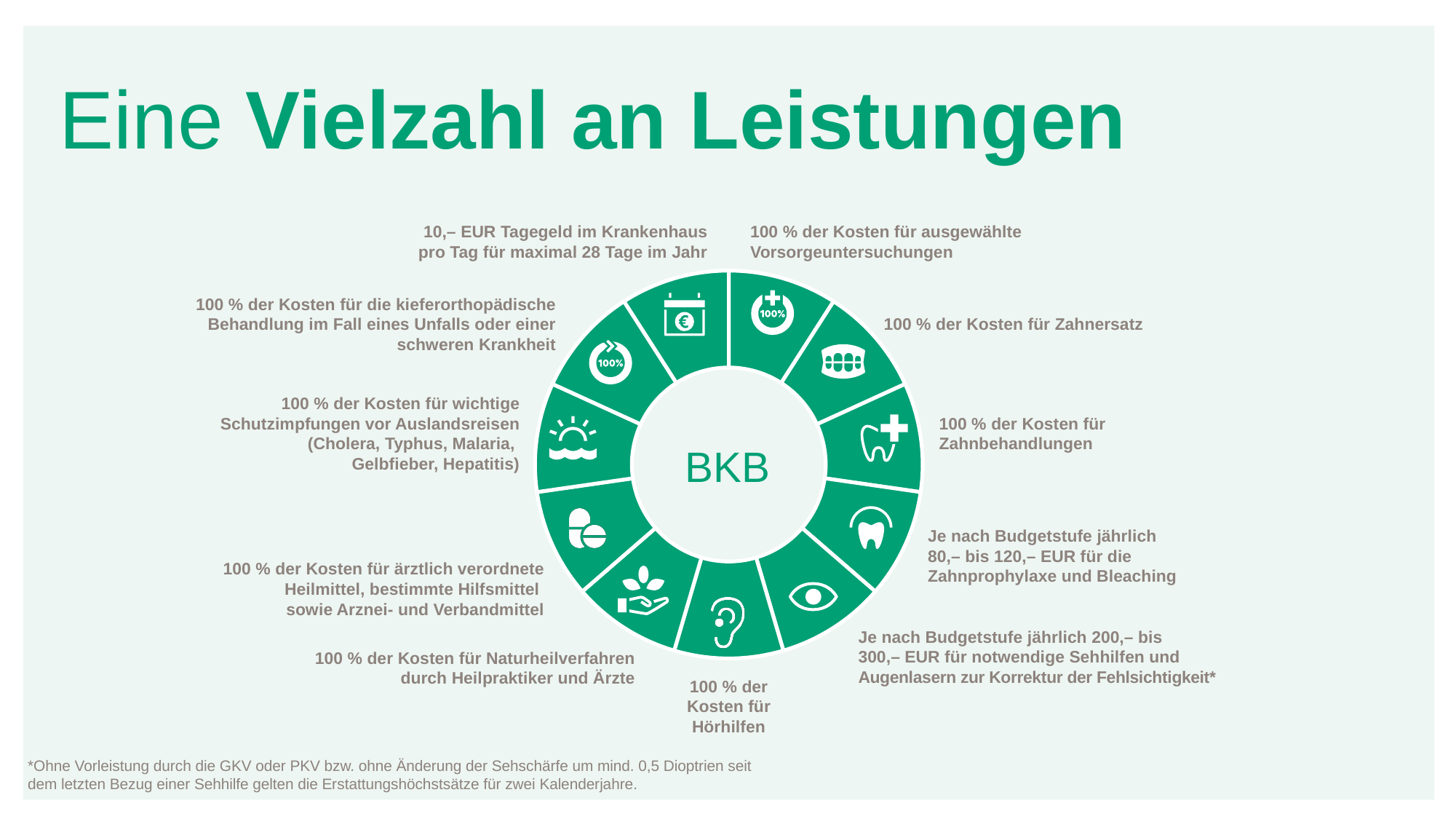
What colour are the segments of the ring diagram? Green How many segments does the ring diagram on the slide have? 11 What annual amount range is given for notwendige Sehhilfen und Augenlasern? 200,– bis 300,– EUR For how many days per year at most is the hospital daily allowance paid, according to the slide? 28 Tage What daily hospital allowance (Tagegeld im Krankenhaus) is listed on the slide? 10,– EUR What annual amount range is given for Zahnprophylaxe und Bleaching? 80,– bis 120,– EUR What text is shown in the centre of the ring diagram? BKB Which is larger: the upper limit for Sehhilfen or the upper limit for Zahnprophylaxe und Bleaching? Sehhilfen What is the difference between the upper limit for Sehhilfen (300,– EUR) and the upper limit for Zahnprophylaxe und Bleaching (120,– EUR)? 180,– EUR What share of the costs for Zahnersatz is covered, according to the slide? 100 % What share of the costs for Hörhilfen is covered, according to the slide? 100 %